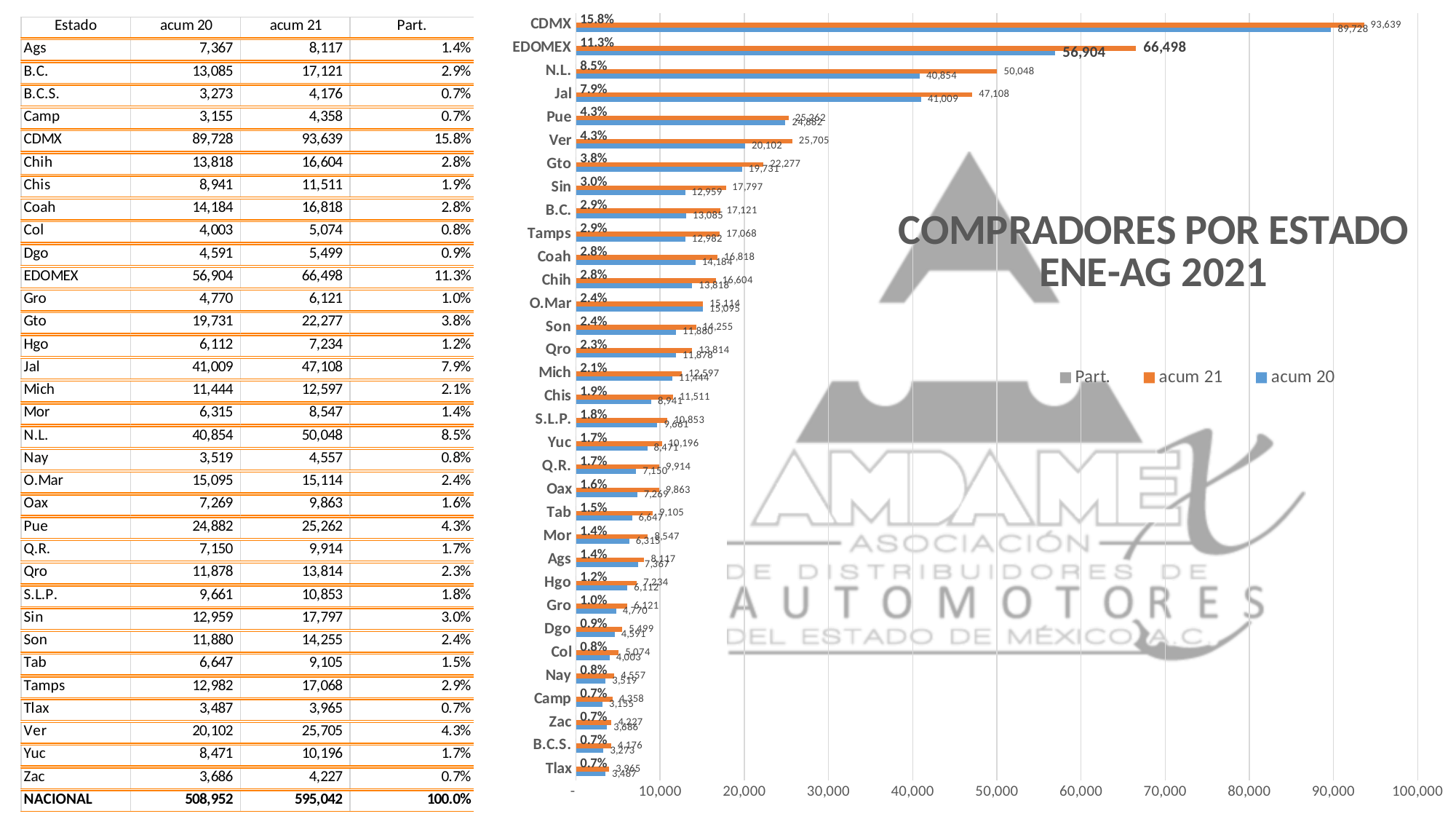
How many series does the chart legend list? 3 Which state has the highest acum 21 value in the chart? CDMX How many states are plotted in the chart? 33 What kind of chart is shown on the slide? bar chart What is the title of the chart? COMPRADORES POR ESTADO ENE-AG 2021 In the chart, what is the acum 20 value for EDOMEX? 56,904 In the chart, what is the Part. value shown for N.L.? 8.5% In the chart, which has the larger acum 21 value, N.L. or Jal? N.L. In the chart, is the acum 20 value for Jal greater or less than 40,000? greater In the chart, what is the acum 21 value for CDMX? 93,639 Which state has the lowest acum 21 value in the chart? Tlax In the chart, what is the difference between the acum 21 and acum 20 values for EDOMEX? 9,594